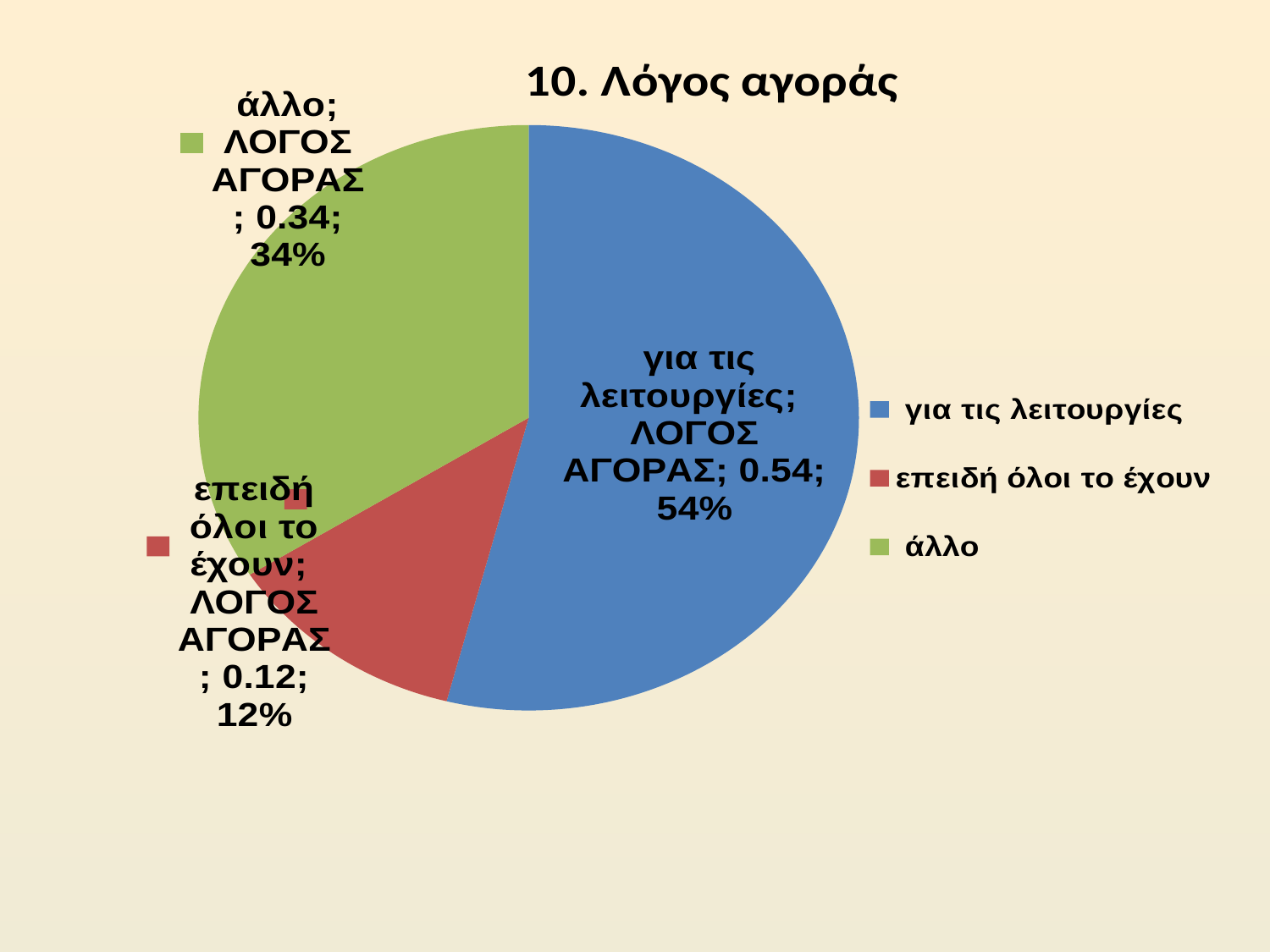
What kind of chart is shown on the slide? pie chart What value is printed for 'για τις λειτουργίες' in the data label? 0.54 What percentage share does the slice 'επειδή όλοι το έχουν' have? 12% What percentage share does the slice 'άλλο' have? 34% What is the title of the chart? 10. Λόγος αγοράς Which category has the smallest slice? επειδή όλοι το έχουν What percentage share does the slice 'για τις λειτουργίες' have? 54% How many slices does the pie chart have? 3 Which category has the largest slice? για τις λειτουργίες What is the difference in percentage points between 'για τις λειτουργίες' and 'άλλο'? 20 percentage points Which is larger, the share for 'άλλο' or the share for 'επειδή όλοι το έχουν'? άλλο What value is printed for 'άλλο' in the data label? 0.34